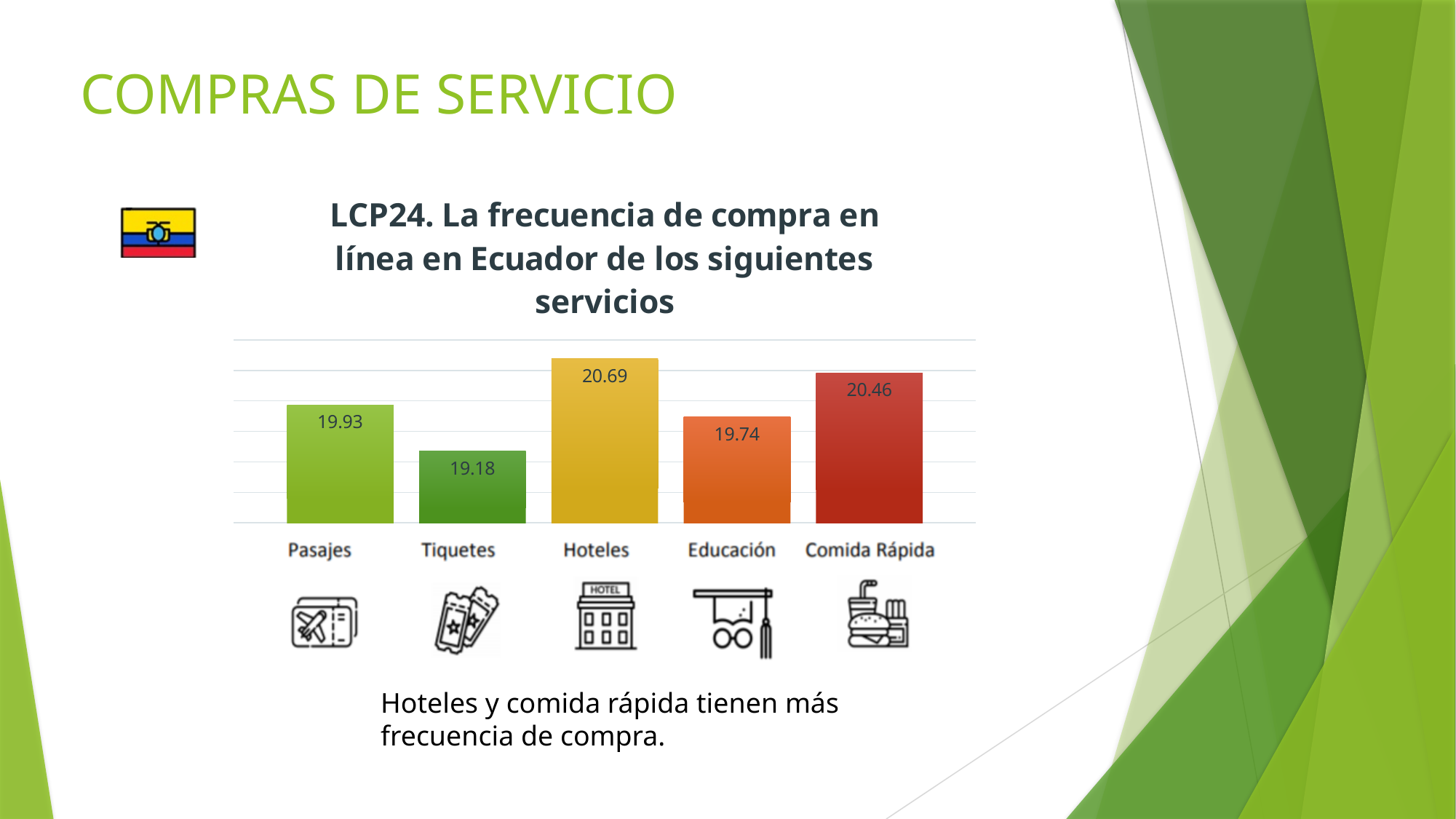
Which category has the highest value? Hoteles What is the value for Comida Rápida? 20.46 What is the value for Educación? 19.74 What is the value for Tiquetes? 19.18 What is the difference between the values for Hoteles and Tiquetes? 1.51 What is the value for Hoteles? 20.69 What is the difference between the values for Comida Rápida and Educación? 0.72 What kind of chart is shown on the slide? Bar chart Which is larger, the value for Pasajes or the value for Educación? Pasajes Which category has the lowest value? Tiquetes How many categories are shown in the chart? 5 What is the value for Pasajes? 19.93